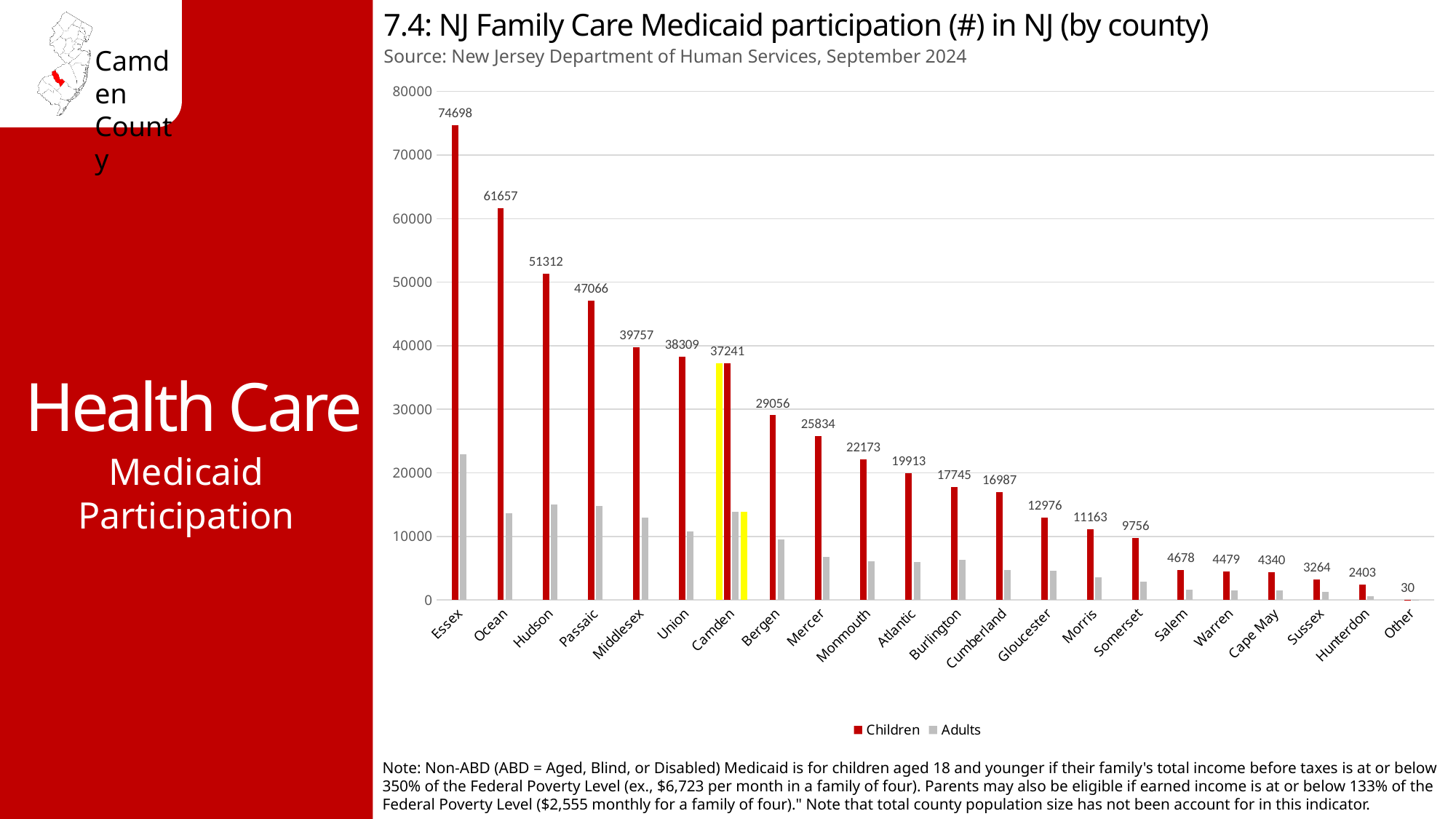
Is the Adults value for Camden greater or less than 20000? less What is the difference between the Children values for Ocean and Hudson? 10345 How many categories are shown on the x axis? 22 What is the Children value for Camden? 37241 What is the Children value for Essex? 74698 Which county has the highest Children value? Essex How many series does the legend list? 2 Is the Adults value for Essex greater or less than 20000? greater Which has a larger Children value, Bergen or Mercer? Bergen Which category has the lowest Children value? Other What kind of chart is shown on the slide? Bar chart What is the Children value for Gloucester? 12976